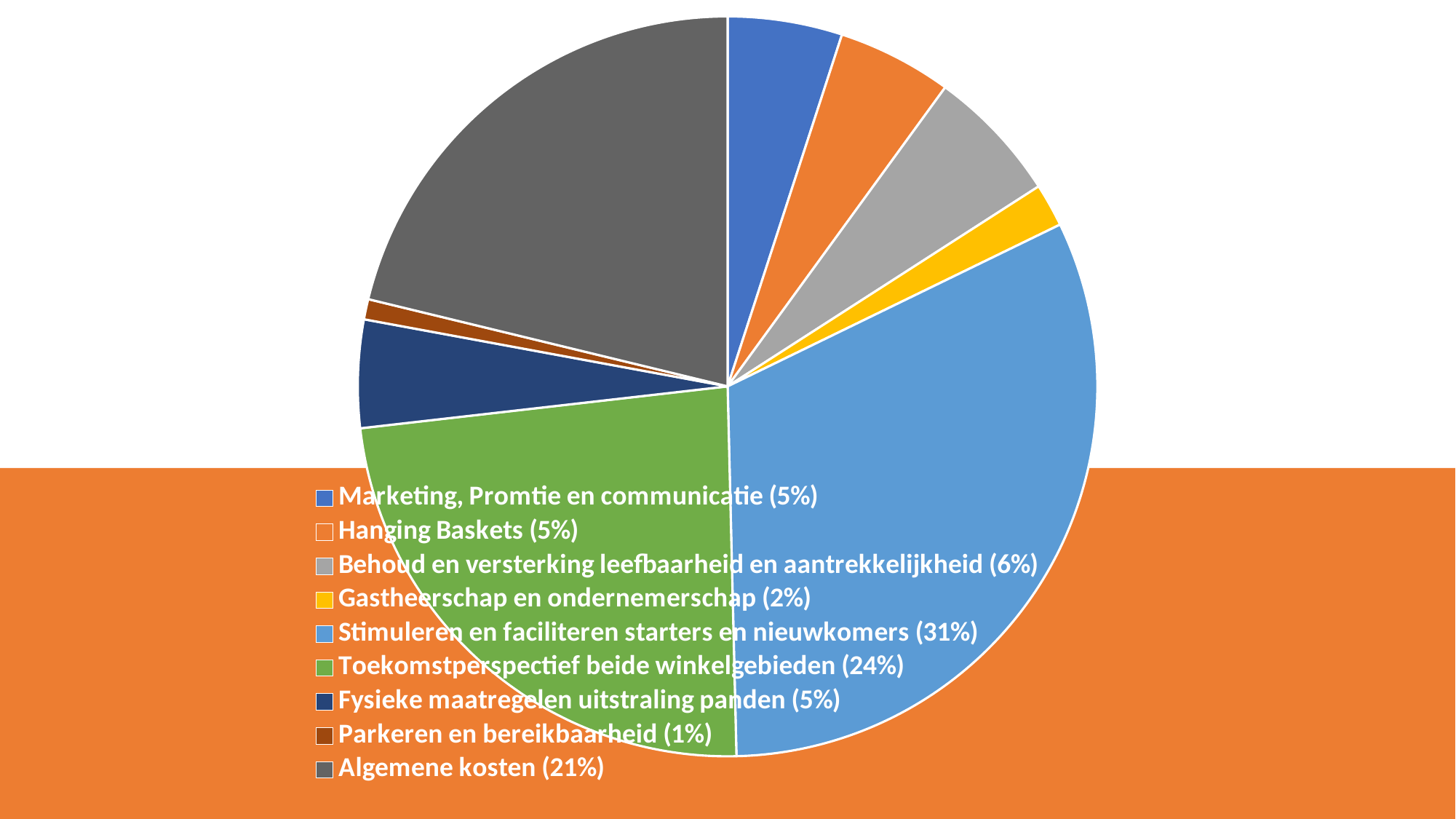
What share of the pie is Toekomstperspectief beide winkelgebieden? 24% What is the difference in percentage points between Stimuleren en faciliteren starters en nieuwkomers and Toekomstperspectief beide winkelgebieden? 7 What colour is the slice for Gastheerschap en ondernemerschap? yellow Which is larger: Algemene kosten or Toekomstperspectief beide winkelgebieden? Toekomstperspectief beide winkelgebieden What percentage is shown for Gastheerschap en ondernemerschap? 2% What share of the pie is Algemene kosten? 21% Which category has the smallest share of the pie? Parkeren en bereikbaarheid How many categories does the pie chart have? 9 What is the combined share of Stimuleren en faciliteren starters en nieuwkomers and Algemene kosten? 52% Which category has the largest share of the pie? Stimuleren en faciliteren starters en nieuwkomers What kind of chart is shown on the slide? pie chart What percentage is shown for Behoud en versterking leefbaarheid en aantrekkelijkheid? 6%